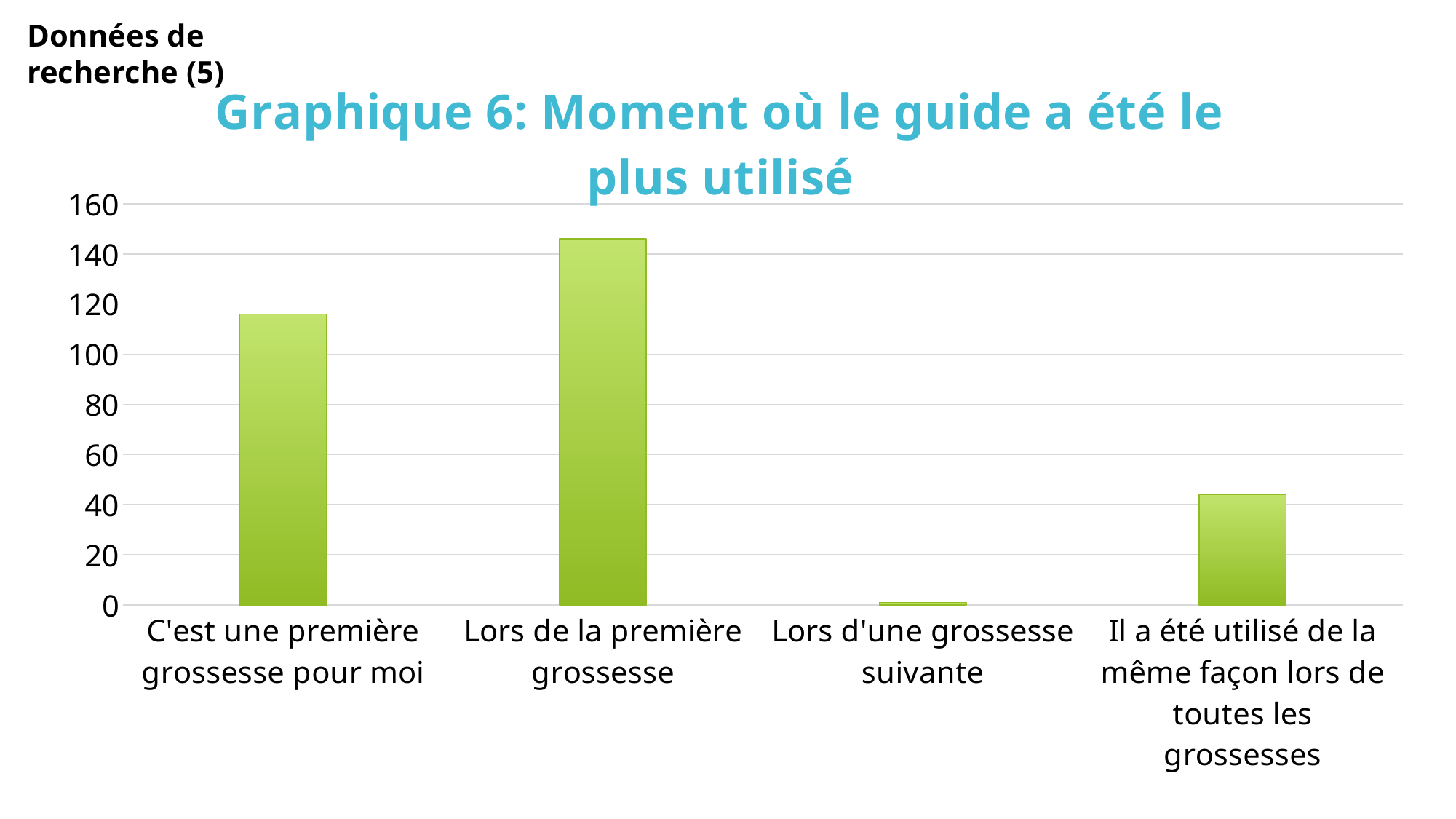
Which is larger: the value for "C'est une première grossesse pour moi" or the value for "Il a été utilisé de la même façon lors de toutes les grossesses"? C'est une première grossesse pour moi Is the value for "Il a été utilisé de la même façon lors de toutes les grossesses" greater or less than 60? less What is the highest value shown on the vertical axis? 160 Is the value for "Lors d'une grossesse suivante" greater or less than 20? less Is the value for "C'est une première grossesse pour moi" greater or less than 100? greater Which category has the lowest value? Lors d'une grossesse suivante What kind of chart is shown on the slide? bar chart How many categories are shown on the x axis of the chart? 4 Which category has the highest value? Lors de la première grossesse What is the title of the chart? Graphique 6: Moment où le guide a été le plus utilisé